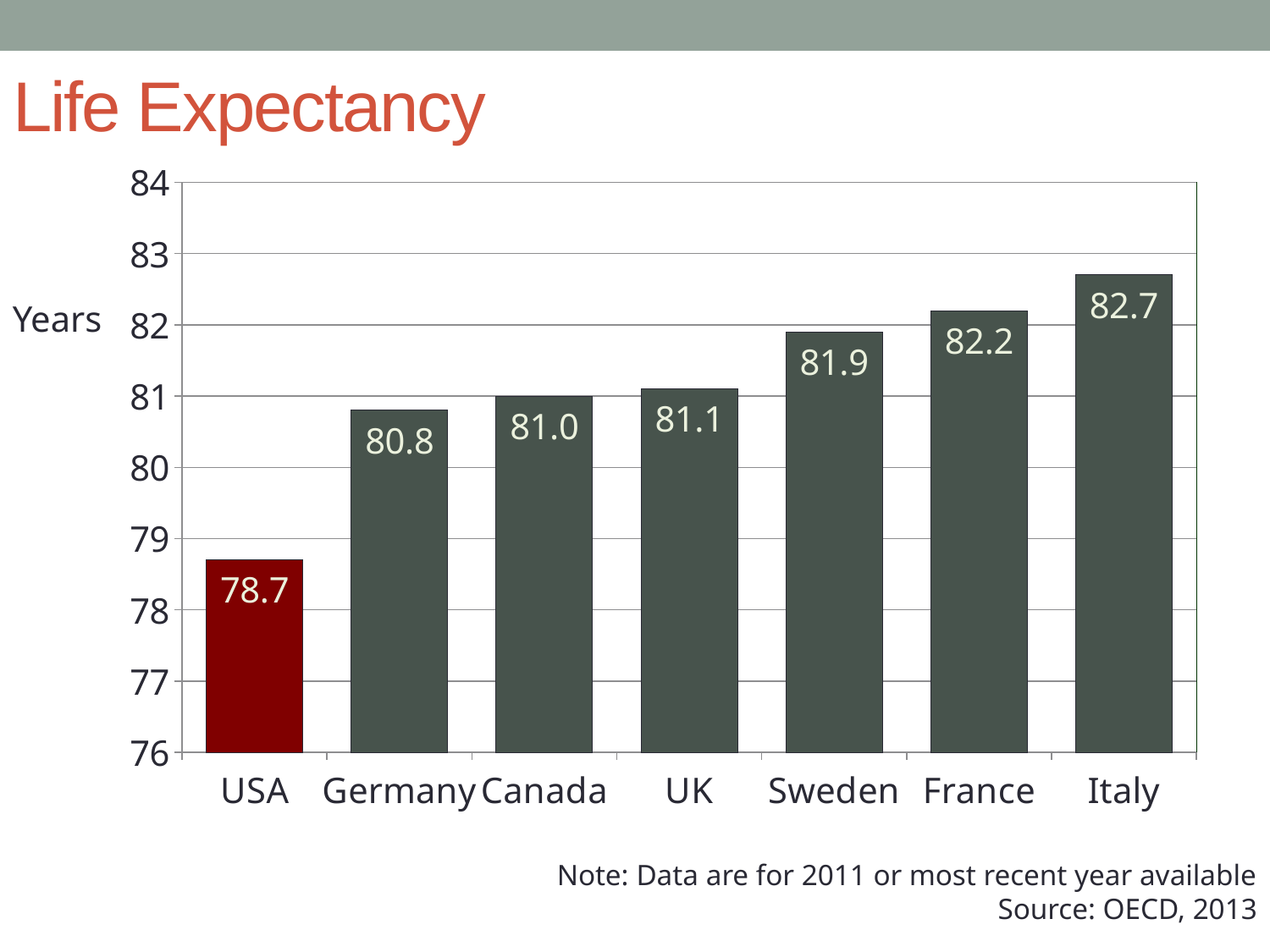
How many countries are shown on the chart? 7 What is the life expectancy value shown for Canada? 81.0 Which bar is coloured differently from the others? USA What kind of chart is shown on the slide? Bar chart Which country has the highest life expectancy on the chart? Italy What is the life expectancy value shown for Sweden? 81.9 What is the life expectancy value shown for the USA? 78.7 What is the difference in life expectancy between France and Germany? 1.4 What is the difference in life expectancy between Italy and the USA? 4.0 Which has a higher life expectancy, Sweden or the UK? Sweden Which country has the lowest life expectancy on the chart? USA Is the value for Germany greater or less than 80? greater